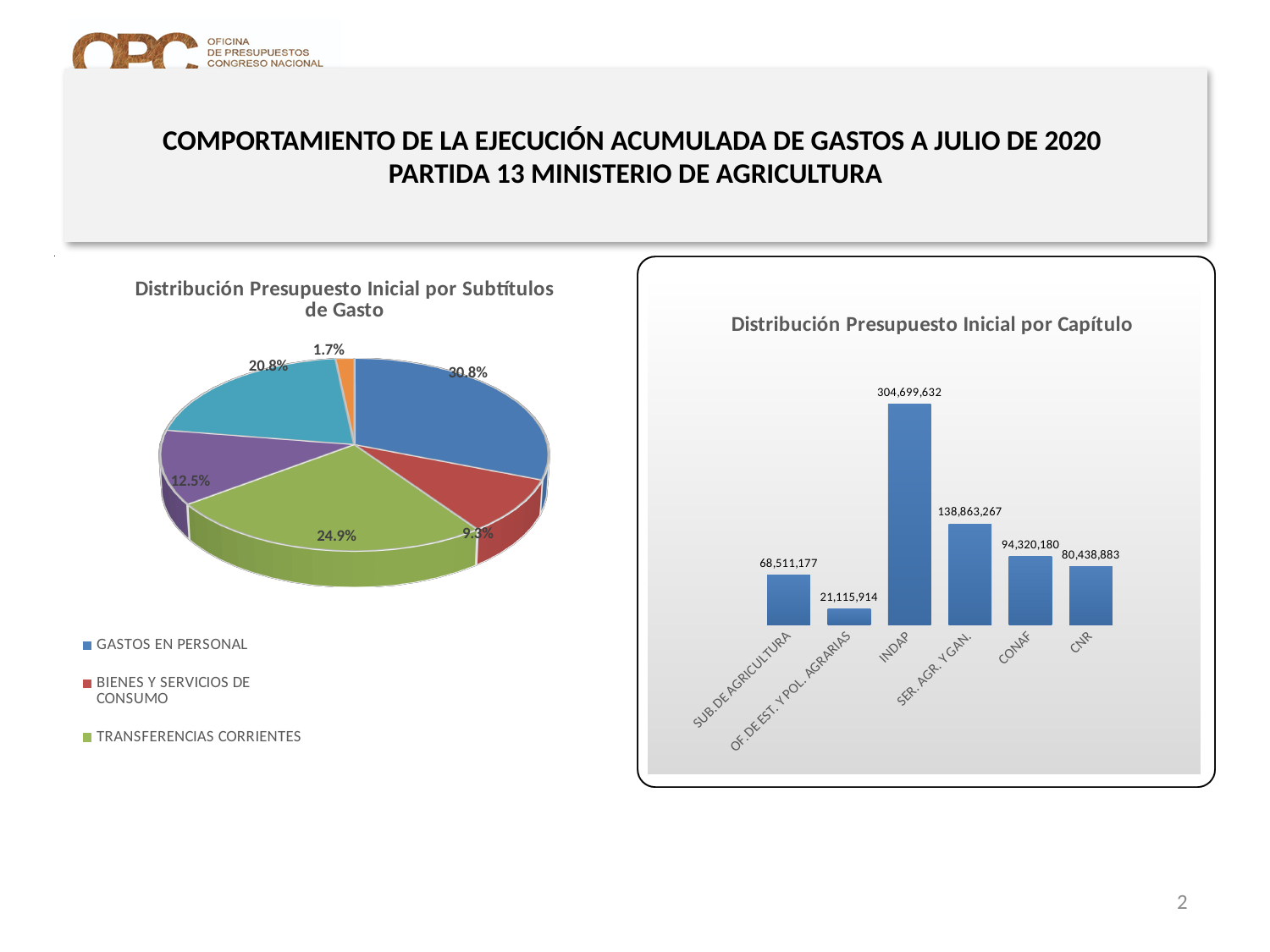
In the 'Distribución Presupuesto Inicial por Subtítulos de Gasto' pie chart, what share does GASTOS EN PERSONAL have? 30.8% What kind of chart is 'Distribución Presupuesto Inicial por Subtítulos de Gasto'? Pie chart In the 'Distribución Presupuesto Inicial por Capítulo' chart, what is the difference between the values for CONAF and CNR? 13,881,297 In the 'Distribución Presupuesto Inicial por Capítulo' chart, what is the value for CONAF? 94,320,180 In the 'Distribución Presupuesto Inicial por Capítulo' chart, what is the value for INDAP? 304,699,632 In the 'Distribución Presupuesto Inicial por Capítulo' chart, which is larger, SER. AGR. Y GAN. or SUB. DE AGRICULTURA? SER. AGR. Y GAN. In the 'Distribución Presupuesto Inicial por Subtítulos de Gasto' pie chart, what share does TRANSFERENCIAS CORRIENTES have? 24.9% In the 'Distribución Presupuesto Inicial por Capítulo' chart, which category has the lowest value? OF. DE EST. Y POL. AGRARIAS In the 'Distribución Presupuesto Inicial por Capítulo' chart, what is the value for OF. DE EST. Y POL. AGRARIAS? 21,115,914 In the 'Distribución Presupuesto Inicial por Capítulo' chart, which category has the highest value? INDAP How many categories are shown in the 'Distribución Presupuesto Inicial por Capítulo' chart? 6 What kind of chart is 'Distribución Presupuesto Inicial por Capítulo'? Bar chart